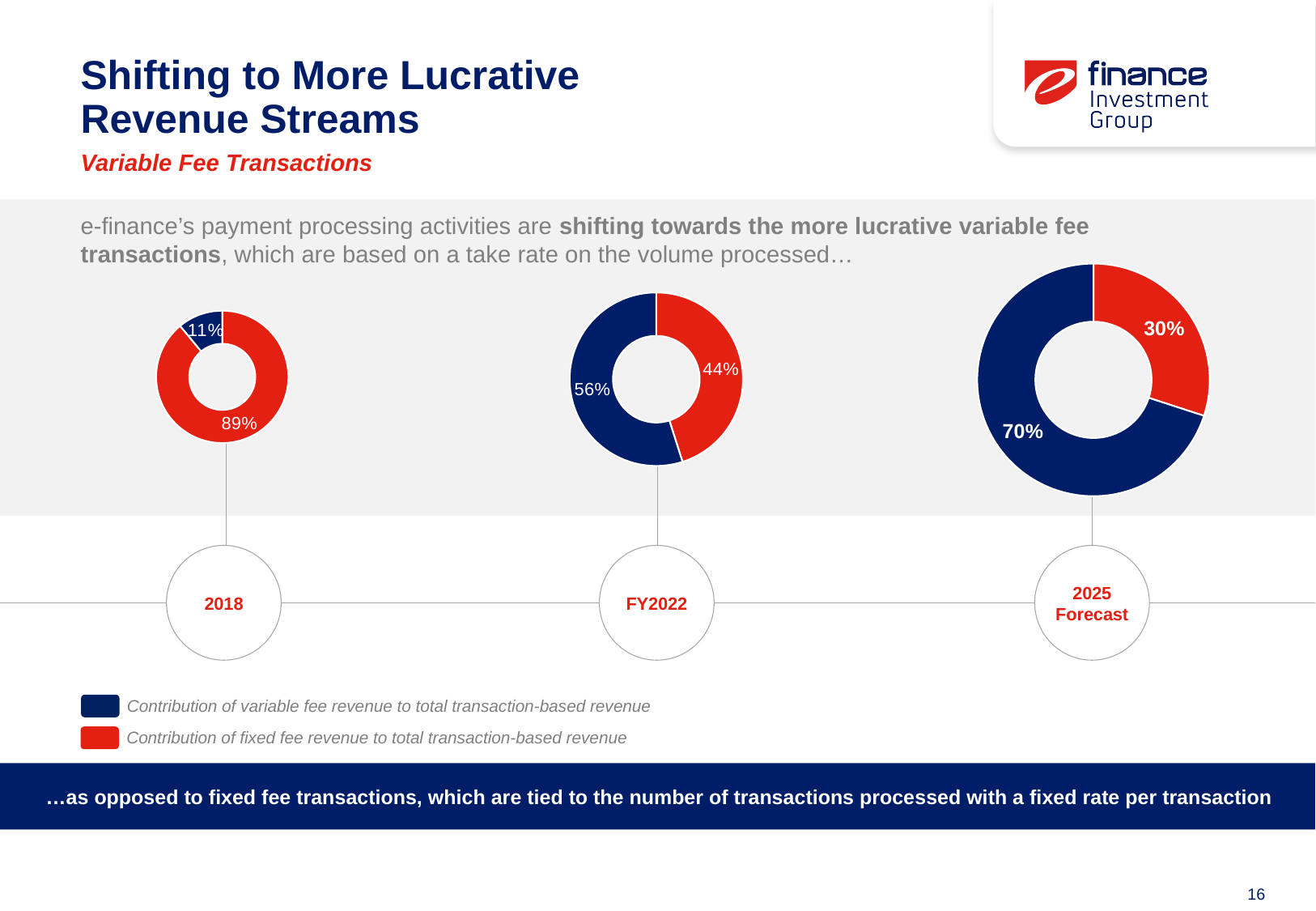
In the 2018 chart, what is the difference between the fixed fee share and the variable fee share? 78% In the FY2022 chart, what is the contribution of fixed fee revenue to total transaction-based revenue? 44% In the 2025 Forecast chart, what is the difference between the variable fee share and the fixed fee share? 40% In the FY2022 chart, which is larger: the variable fee share or the fixed fee share? Variable fee share In the 2018 chart, what is the contribution of fixed fee revenue to total transaction-based revenue? 89% In the 2025 Forecast chart, what is the contribution of fixed fee revenue to total transaction-based revenue? 30% In the 2025 Forecast chart, what is the contribution of variable fee revenue to total transaction-based revenue? 70% What kind of chart is used to show the revenue contributions for each year on this slide? Donut (pie) chart How does the contribution of variable fee revenue change from 2018 to the 2025 Forecast across the three charts? It rises In the FY2022 chart, what is the contribution of variable fee revenue to total transaction-based revenue? 56% Which colour represents the contribution of fixed fee revenue in the charts? Red In the 2018 chart, what is the contribution of variable fee revenue to total transaction-based revenue? 11%